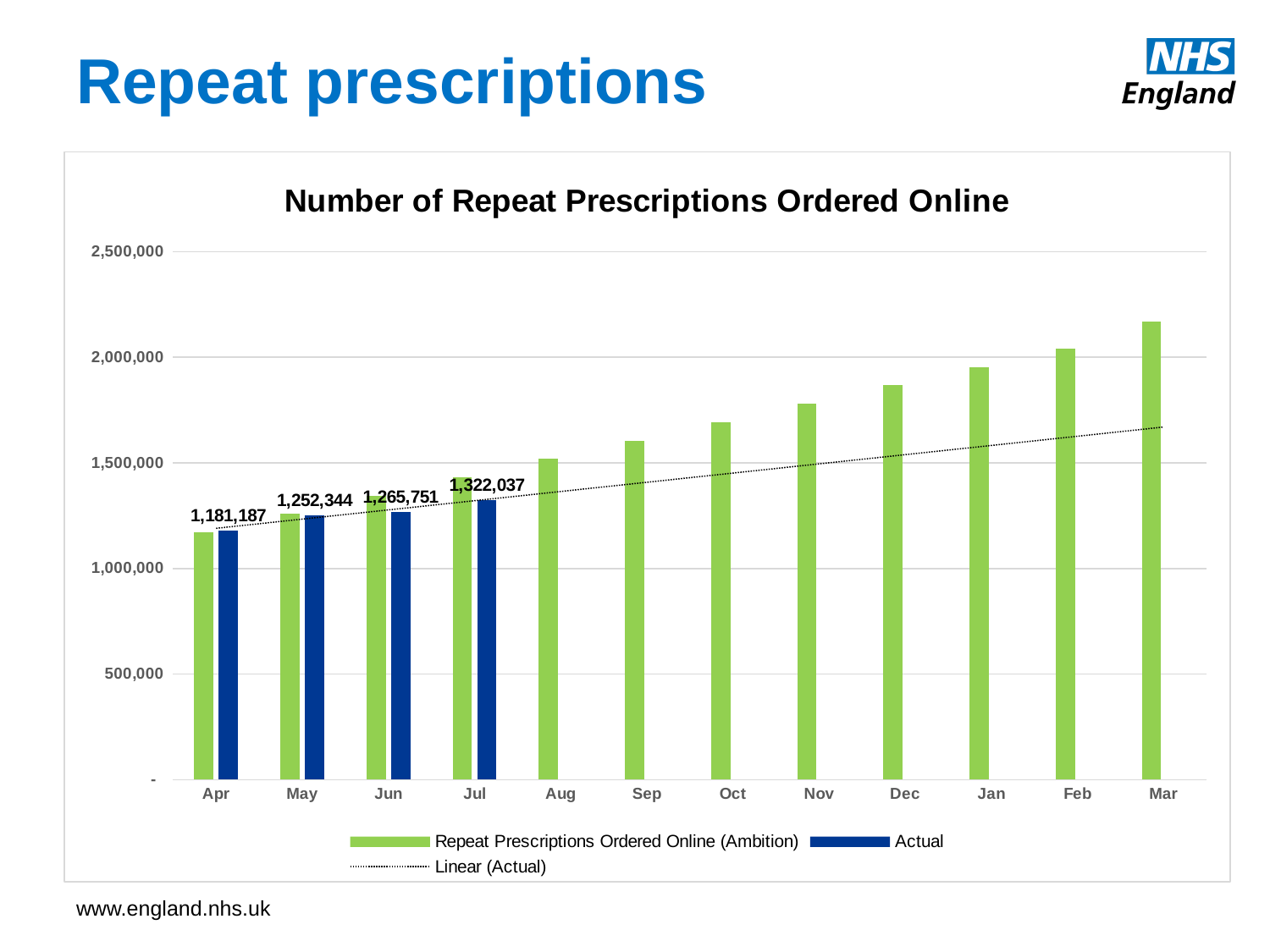
Which month has the highest Actual value? Jul How many entries does the legend list? 3 Which month has the lowest Actual value? Apr Do the Ambition values rise or fall from Apr to Mar? Rise What is the Actual value for May? 1,252,344 What kind of chart is shown? Bar chart What is the difference between the Actual values for Jul and Apr? 140,850 What is the Actual value for Jul? 1,322,037 What is the Actual value for Apr? 1,181,187 Is the Ambition value for Mar greater or less than 2,000,000? greater How many months are shown on the x axis? 12 Is the Ambition value for Dec greater or less than 2,000,000? less